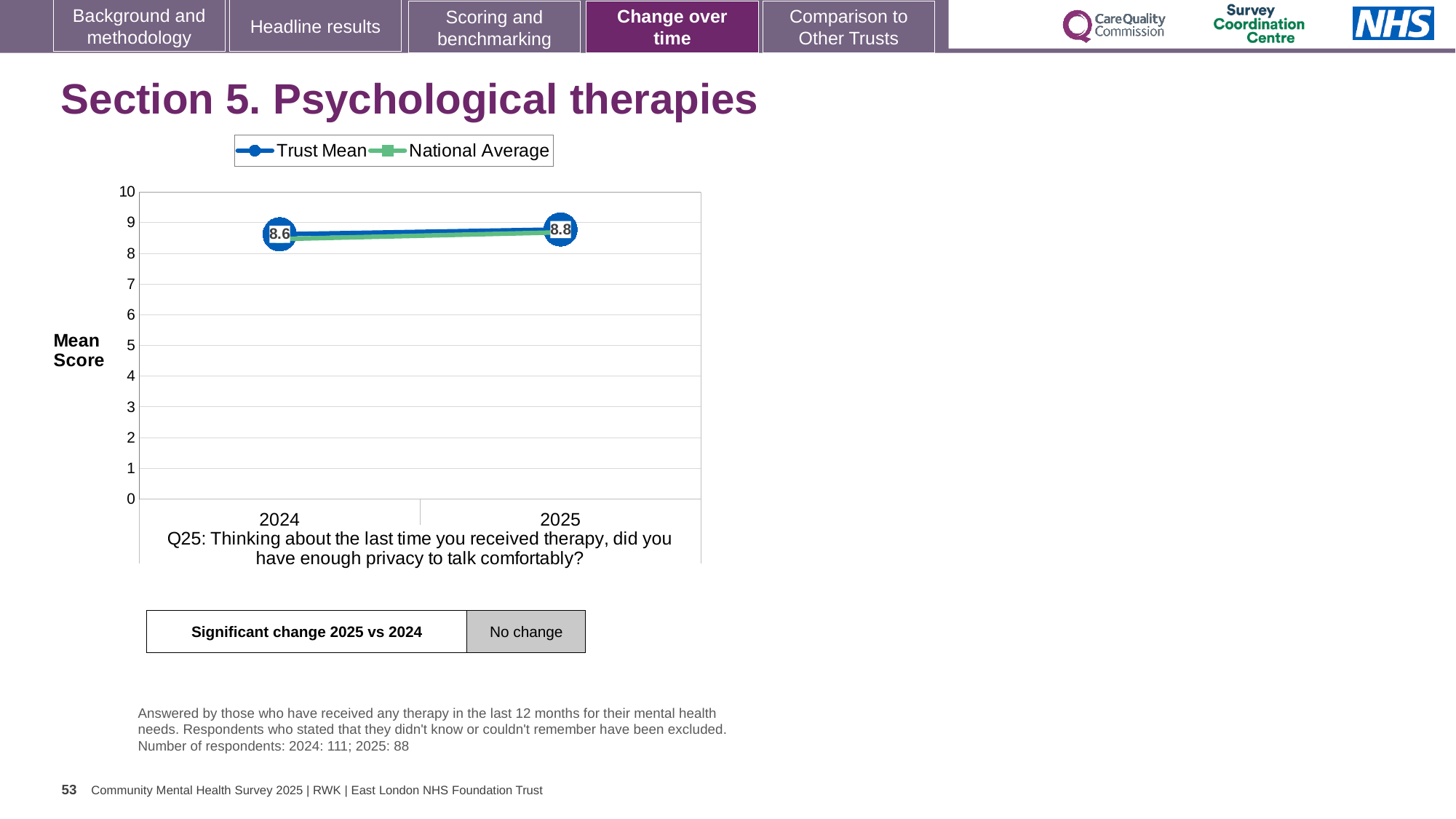
By how much did the Trust Mean change from 2024 to 2025? 0.2 How many series does the chart legend list? 2 What kind of chart is shown on the slide? line chart What is the label on the y axis of the chart? Mean Score What is the Trust Mean value for 2025? 8.8 Does the Trust Mean rise or fall from 2024 to 2025? rise Which year has the higher Trust Mean, 2024 or 2025? 2025 How many years are shown on the x axis of the chart? 2 In which year is the Trust Mean lowest? 2024 Is the National Average value for 2024 greater or less than 5? greater What is the Trust Mean value for 2024? 8.6 In which year is the Trust Mean highest? 2025